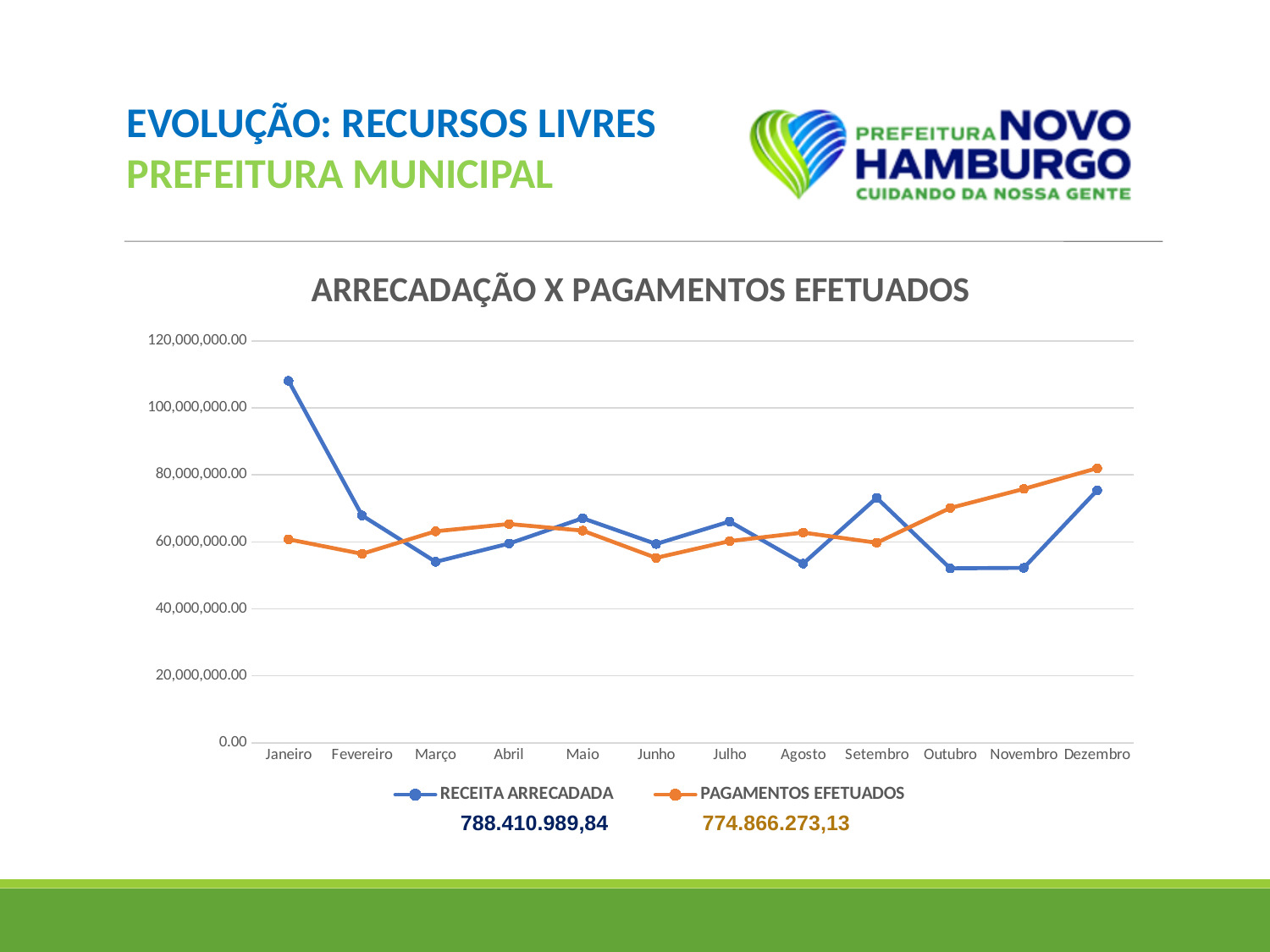
In which month is PAGAMENTOS EFETUADOS highest? Dezembro In Dezembro, which series has the larger value, RECEITA ARRECADADA or PAGAMENTOS EFETUADOS? PAGAMENTOS EFETUADOS What kind of chart is shown on the slide? line chart What total is printed under the RECEITA ARRECADADA legend entry? 788.410.989,84 Is the RECEITA ARRECADADA value for Janeiro greater or less than 100,000,000.00? greater How many series does the legend list? 2 In which month is RECEITA ARRECADADA highest? Janeiro Is the RECEITA ARRECADADA value for Outubro greater or less than 60,000,000.00? less How many months are plotted along the x axis? 12 In Janeiro, which series has the larger value, RECEITA ARRECADADA or PAGAMENTOS EFETUADOS? RECEITA ARRECADADA Does the PAGAMENTOS EFETUADOS line rise or fall from Setembro to Dezembro? rise What is the title of the chart? ARRECADAÇÃO X PAGAMENTOS EFETUADOS